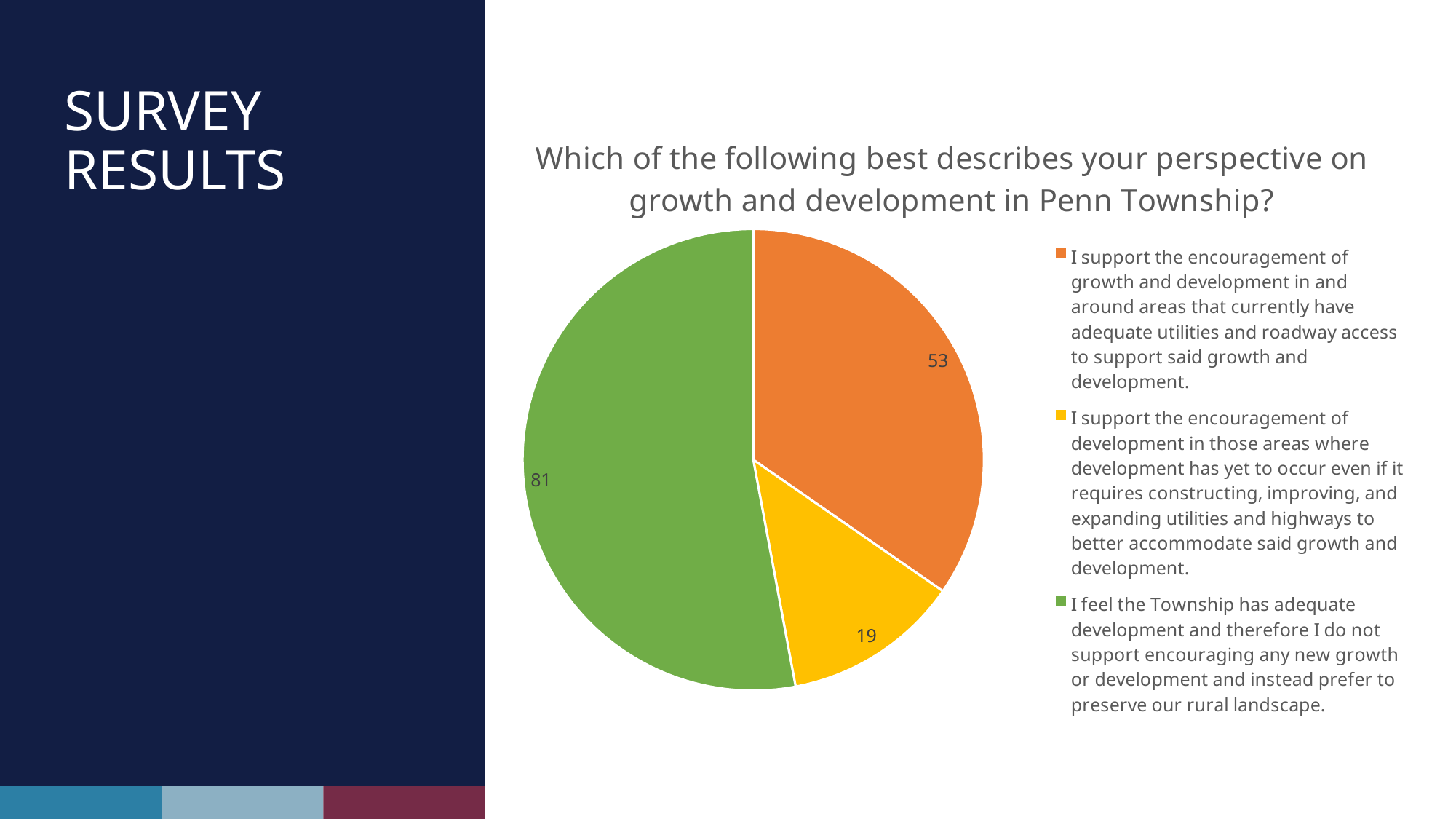
What is the total of all three slices in the pie chart? 153 What is the title of the pie chart? Which of the following best describes your perspective on growth and development in Penn Township? What is the difference between the green slice (81) and the orange slice (53)? 28 Which response option has the largest slice in the pie chart? I feel the Township has adequate development and therefore I do not support encouraging any new growth or development and instead prefer to preserve our rural landscape. What is the value of the green slice, for respondents who feel the Township has adequate development and prefer to preserve the rural landscape? 81 What is the value of the orange slice, for respondents who support growth in areas that currently have adequate utilities and roadway access? 53 How many entries does the legend of the pie chart list? 3 How many slices does the pie chart have? 3 What type of chart is shown on the slide? pie chart Which is larger, the orange slice or the yellow slice? the orange slice What is the value of the yellow slice, for respondents who support development in areas where development has yet to occur? 19